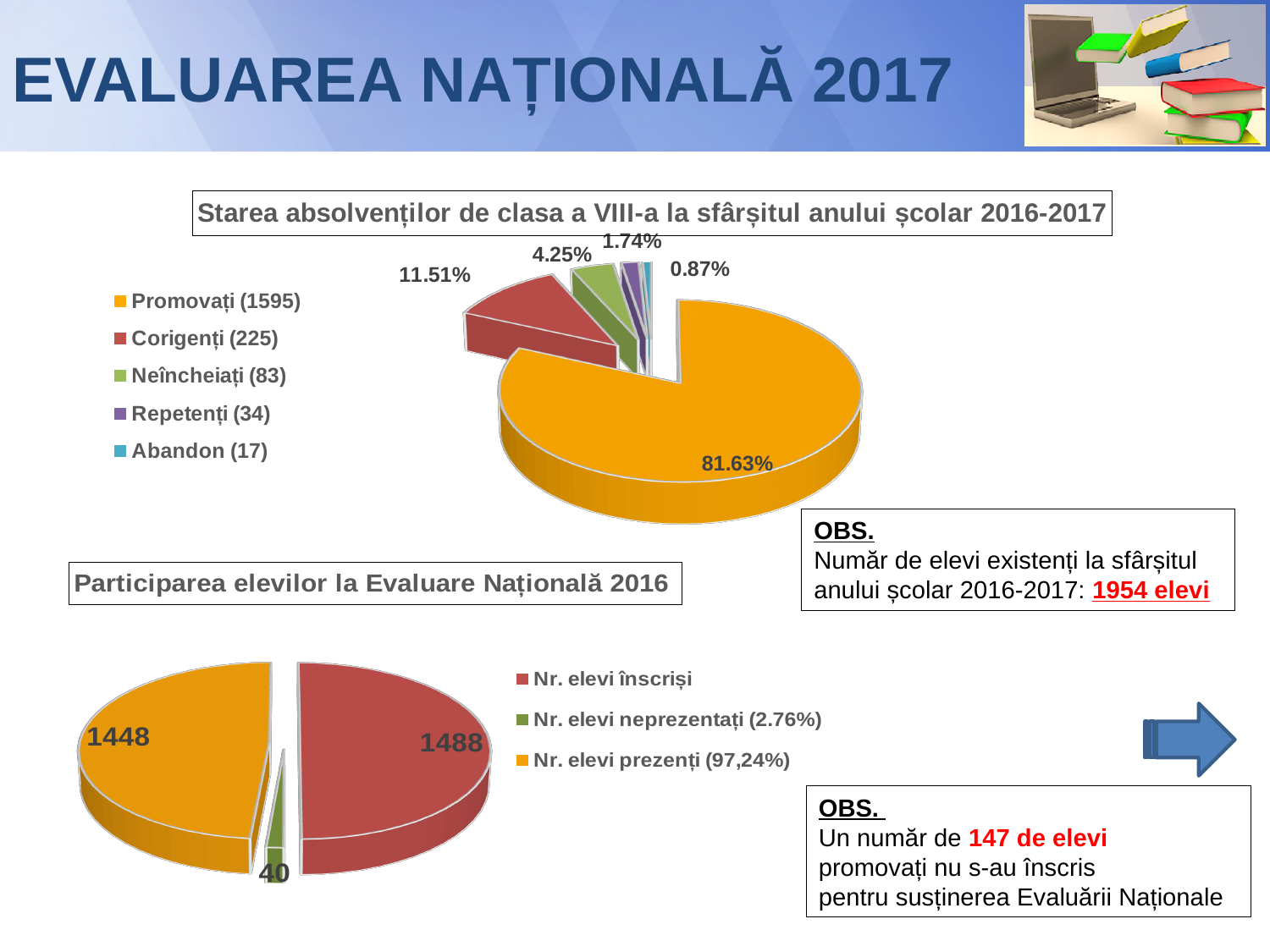
In the chart 'Starea absolvenților de clasa a VIII-a la sfârșitul anului școlar 2016-2017', what percentage is shown for Abandon? 0.87% In the chart 'Participarea elevilor la Evaluare Națională 2016', what is the difference between Nr. elevi înscriși and Nr. elevi prezenți? 40 In the chart 'Starea absolvenților de clasa a VIII-a la sfârșitul anului școlar 2016-2017', what percentage is shown for the Promovați slice? 81.63% In the chart 'Participarea elevilor la Evaluare Națională 2016', what value is shown for Nr. elevi înscriși? 1488 In the chart 'Starea absolvenților de clasa a VIII-a la sfârșitul anului școlar 2016-2017', what number of students is given in the legend for Repetenți? 34 What type of chart is 'Participarea elevilor la Evaluare Națională 2016'? Pie chart In the chart 'Starea absolvenților de clasa a VIII-a la sfârșitul anului școlar 2016-2017', which category has the largest slice? Promovați In the chart 'Starea absolvenților de clasa a VIII-a la sfârșitul anului școlar 2016-2017', what percentage is shown for Corigenți? 11.51% In the chart 'Starea absolvenților de clasa a VIII-a la sfârșitul anului școlar 2016-2017', which category has the smallest slice? Abandon In the chart 'Participarea elevilor la Evaluare Națională 2016', what value is shown for Nr. elevi neprezentați? 40 In the chart 'Starea absolvenților de clasa a VIII-a la sfârșitul anului școlar 2016-2017', how many categories does the legend list? 5 In the chart 'Starea absolvenților de clasa a VIII-a la sfârșitul anului școlar 2016-2017', what is the difference in percentage points between Corigenți and Neîncheiați? 7.26